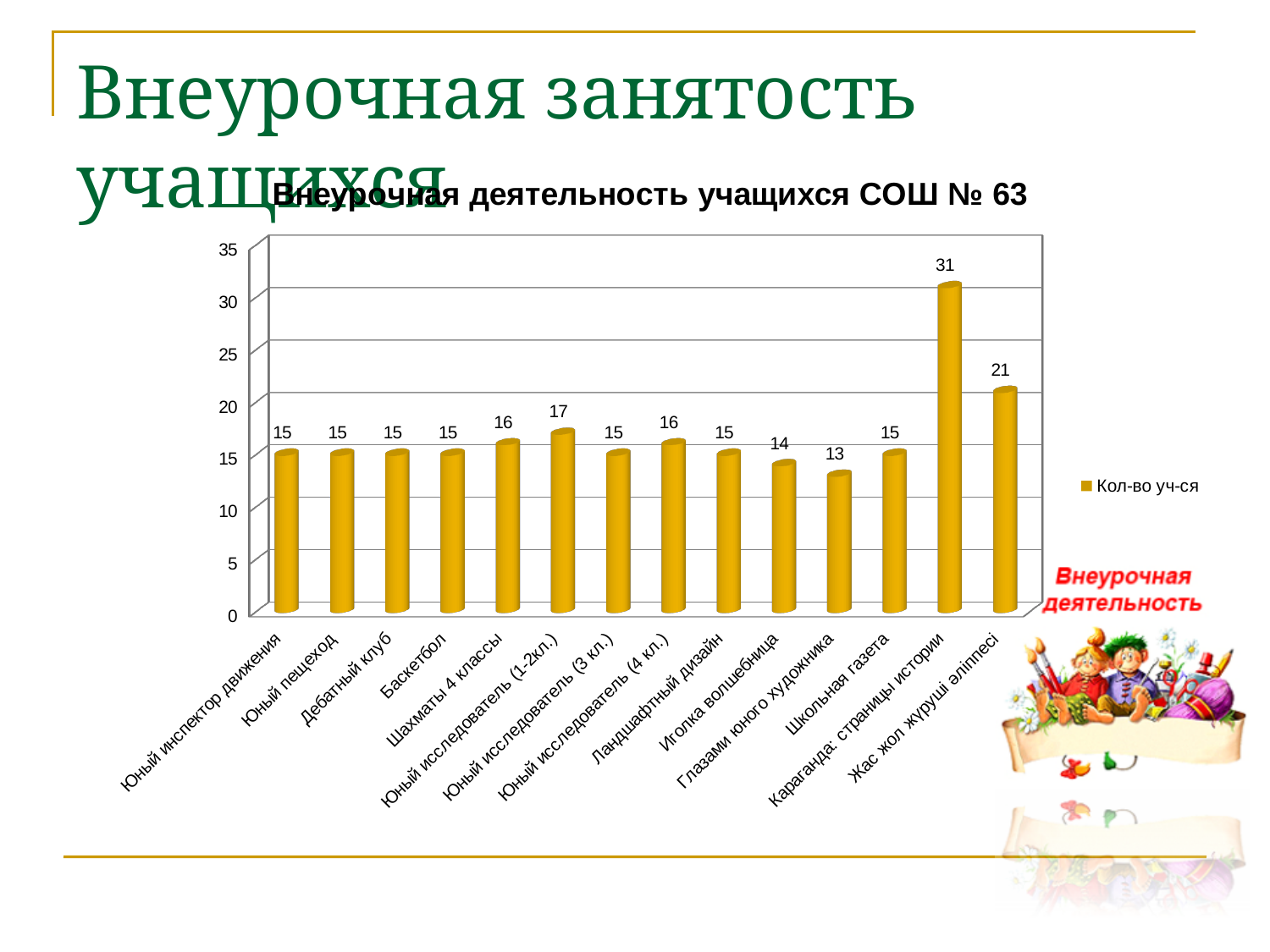
What kind of chart is shown on the slide? bar chart What is the value for Глазами юного художника? 13 What series name does the legend list? Кол-во уч-ся Is the value for Караганда: страницы истории greater or less than 30? greater What is the difference between the values for Караганда: страницы истории and Жас жол жүруші әліппесі? 10 How many categories are shown on the x axis? 14 Which category has the highest value? Караганда: страницы истории What is the value for Караганда: страницы истории? 31 What is the value for Юный исследователь (1-2кл.)? 17 Which is larger, the value for Шахматы 4 классы or the value for Иголка волшебница? Шахматы 4 классы What is the value for Жас жол жүруші әліппесі? 21 Which category has the lowest value? Глазами юного художника